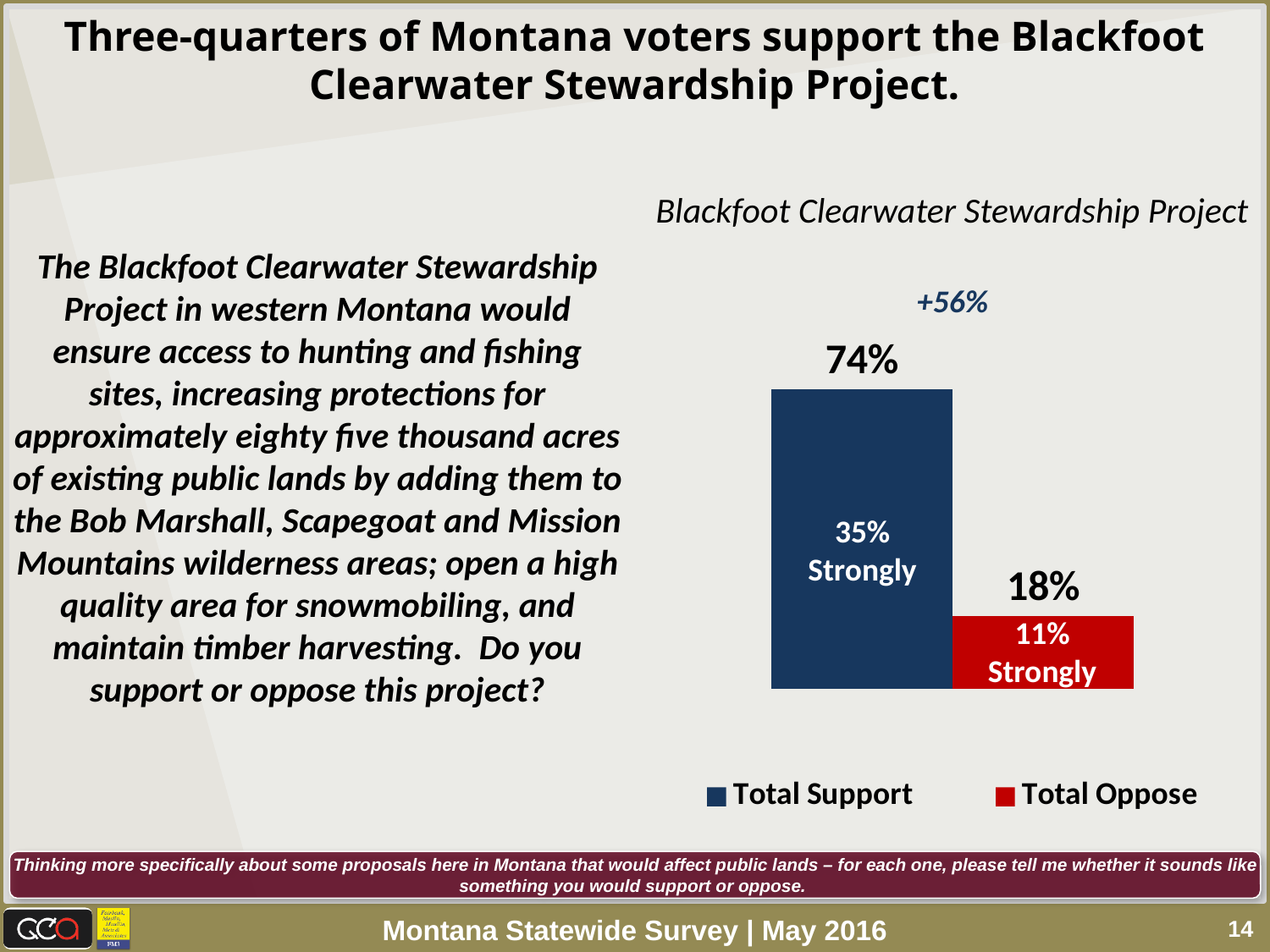
What colour is the Total Oppose bar? Red What is the value for Total Oppose? 18% How many series does the legend list? 2 Which bar is higher, Total Support or Total Oppose? Total Support What is the title of the chart? Blackfoot Clearwater Stewardship Project How many bars are shown in the chart? 2 What net figure is printed above the bars? +56% What is the difference between Total Support and Total Oppose? 56% What kind of chart is shown? Bar chart What share of voters strongly oppose the project? 11% What is the value for Total Support? 74% What share of voters strongly support the project? 35%